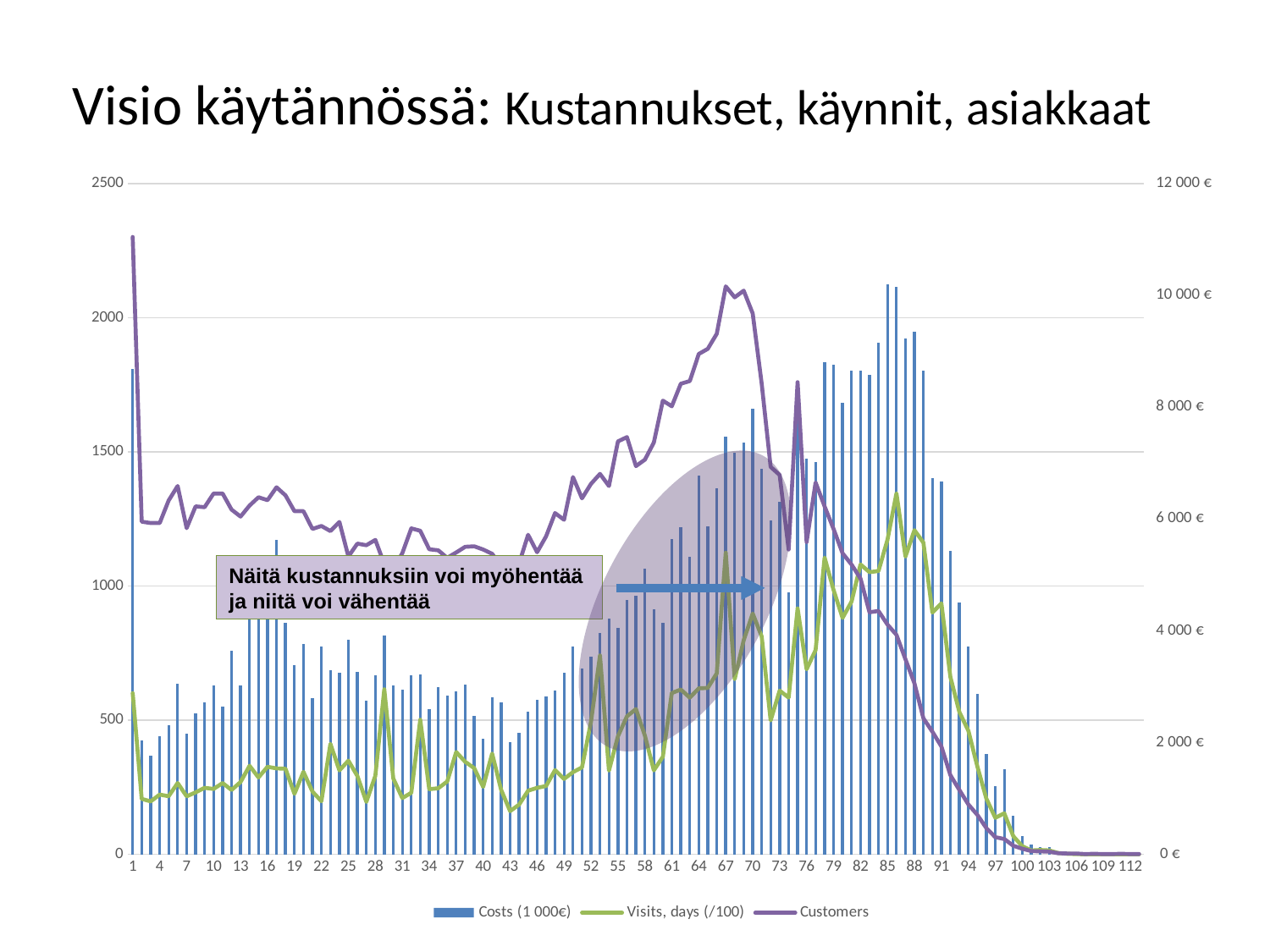
Does the Customers line rise or fall between points 100 and 112? fall What is the highest value shown on the left vertical axis? 2500 Which series is drawn as bars? Costs (1 000€) Read against the left axis, is the Customers line at point 1 greater or less than 2000? greater What colour is the Customers line? Purple Does the Customers line rise or fall between points 52 and 67? rise What kind of chart is shown on the slide? A combined bar and line chart What is the last category label on the x axis? 112 What is the highest value shown on the right vertical axis? 12 000 € Read against the left axis, is the Customers line at point 112 greater or less than 500? less Read against the left axis, is the Visits, days (/100) line at point 1 greater or less than 1000? less How many series does the legend list? 3